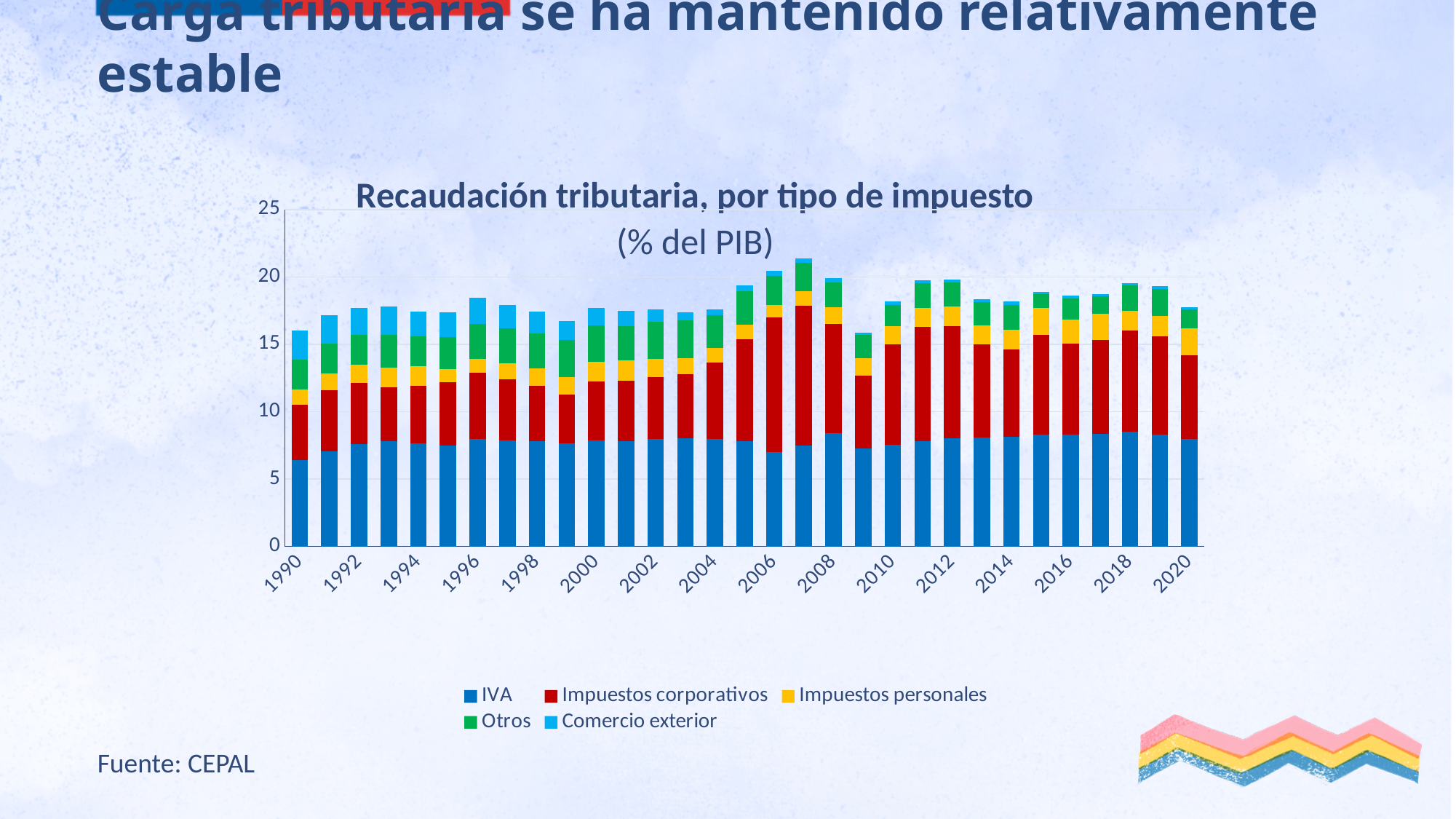
Which year has the highest total tax revenue in the chart? 2007 Is the total stacked value for 1990 greater or less than 20? less Is the IVA value for 1990 greater or less than 10? less What is the title of the chart? Recaudación tributaria, por tipo de impuesto (% del PIB) How many years (bars) are plotted in the chart? 31 What kind of chart is shown on the slide? Stacked bar chart In 2007, which series has the larger segment, IVA or Impuestos corporativos? Impuestos corporativos Which series forms the bottom segment of each stacked bar? IVA Is the total stacked value for 2007 greater or less than 20? greater Which year has a larger total tax revenue, 2007 or 1990? 2007 How many series does the legend list? 5